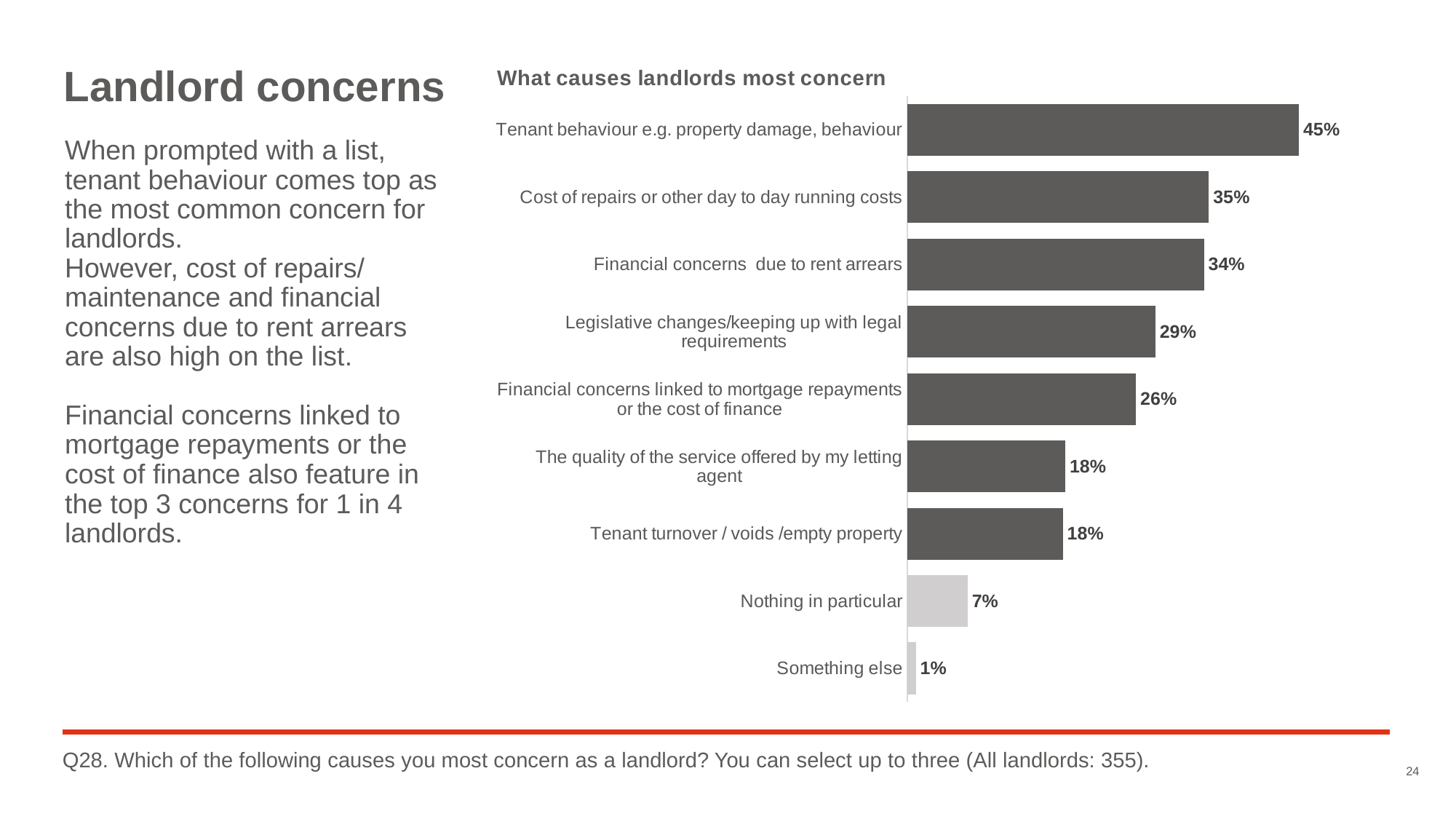
What type of chart is shown on the slide? Bar chart What is the value for 'Nothing in particular'? 7% How many categories are shown in the chart? 9 Which category has the highest value in the chart? Tenant behaviour e.g. property damage, behaviour What is the difference between the values for tenant behaviour and cost of repairs? 10 percentage points Which category has the lowest value in the chart? Something else What is the difference between the values for 'Nothing in particular' and 'Something else'? 6 percentage points What percentage is shown for 'Legislative changes/keeping up with legal requirements'? 29% What percentage of landlords cited tenant behaviour as a concern? 45% What is the value for 'Cost of repairs or other day to day running costs'? 35% What is the title of the chart? What causes landlords most concern Which is larger: the value for 'Financial concerns due to rent arrears' or 'Financial concerns linked to mortgage repayments or the cost of finance'? Financial concerns due to rent arrears